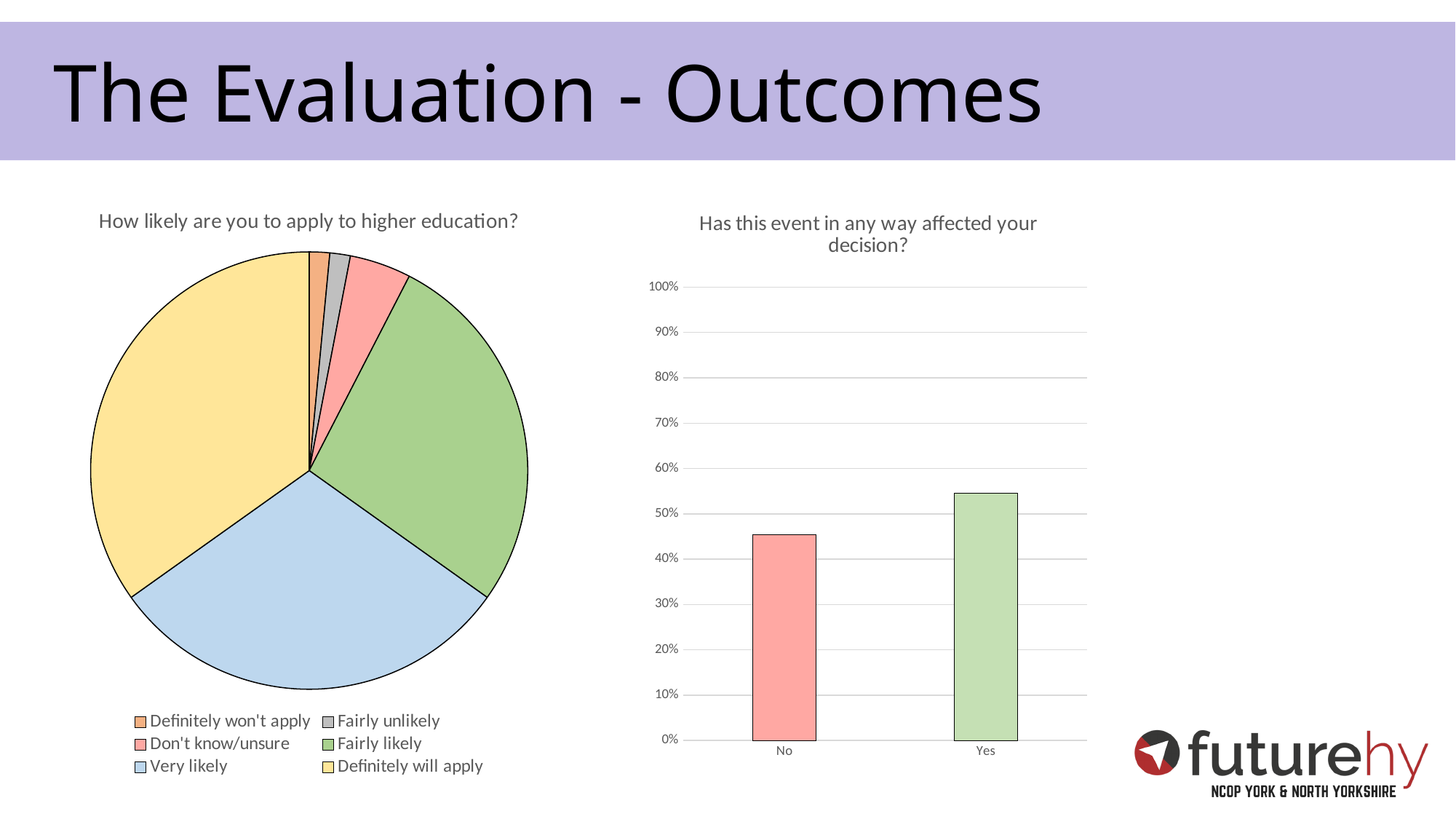
In the bar chart "Has this event in any way affected your decision?", which category has the highest value? Yes In the pie chart "How likely are you to apply to higher education?", how many categories does the legend list? 6 What kind of chart is the chart titled "How likely are you to apply to higher education?"? pie chart In the pie chart "How likely are you to apply to higher education?", what colour is the Very likely slice? blue In the bar chart "Has this event in any way affected your decision?", is the value for Yes greater or less than 50%? greater In the bar chart "Has this event in any way affected your decision?", is the value for No greater or less than 50%? less In the bar chart "Has this event in any way affected your decision?", which category has the lowest value? No In the pie chart "How likely are you to apply to higher education?", which slice is larger: Don't know/unsure or Fairly unlikely? Don't know/unsure In the pie chart "How likely are you to apply to higher education?", which slice is larger: Very likely or Fairly likely? Very likely In the bar chart "Has this event in any way affected your decision?", how many categories are shown on the x axis? 2 What kind of chart is the chart titled "Has this event in any way affected your decision?"? bar chart In the pie chart "How likely are you to apply to higher education?", which category has the largest slice? Definitely will apply